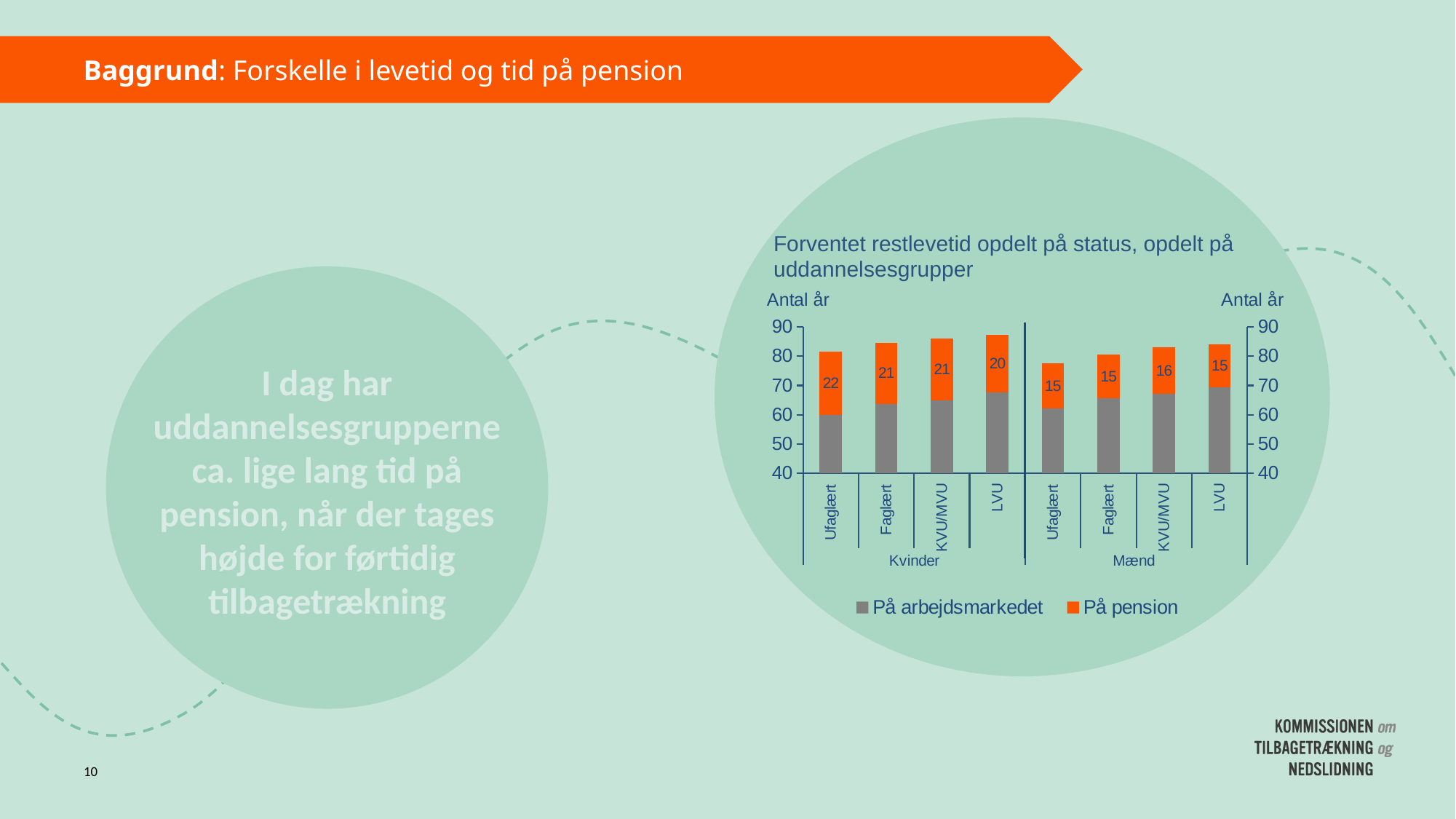
What is the difference between the 'På pension' values for Ufaglært women and Ufaglært men? 7 Is the total bar height for LVU women (Kvinder) greater or less than 80? greater How many series does the legend list? 2 What is the 'På pension' value for LVU women (Kvinder)? 20 Is the total bar height for Ufaglært men (Mænd) greater or less than 80? less Which group has the highest 'På pension' value? Ufaglært (Kvinder) How many bars are shown in the chart? 8 What is the 'På pension' value for Ufaglært women (Kvinder)? 22 What is the 'På pension' value for KVU/MVU men (Mænd)? 16 What type of chart is shown? Stacked bar chart Which is larger, the 'På pension' value for LVU women or LVU men? LVU women (Kvinder) What is the 'På pension' value for LVU men (Mænd)? 15